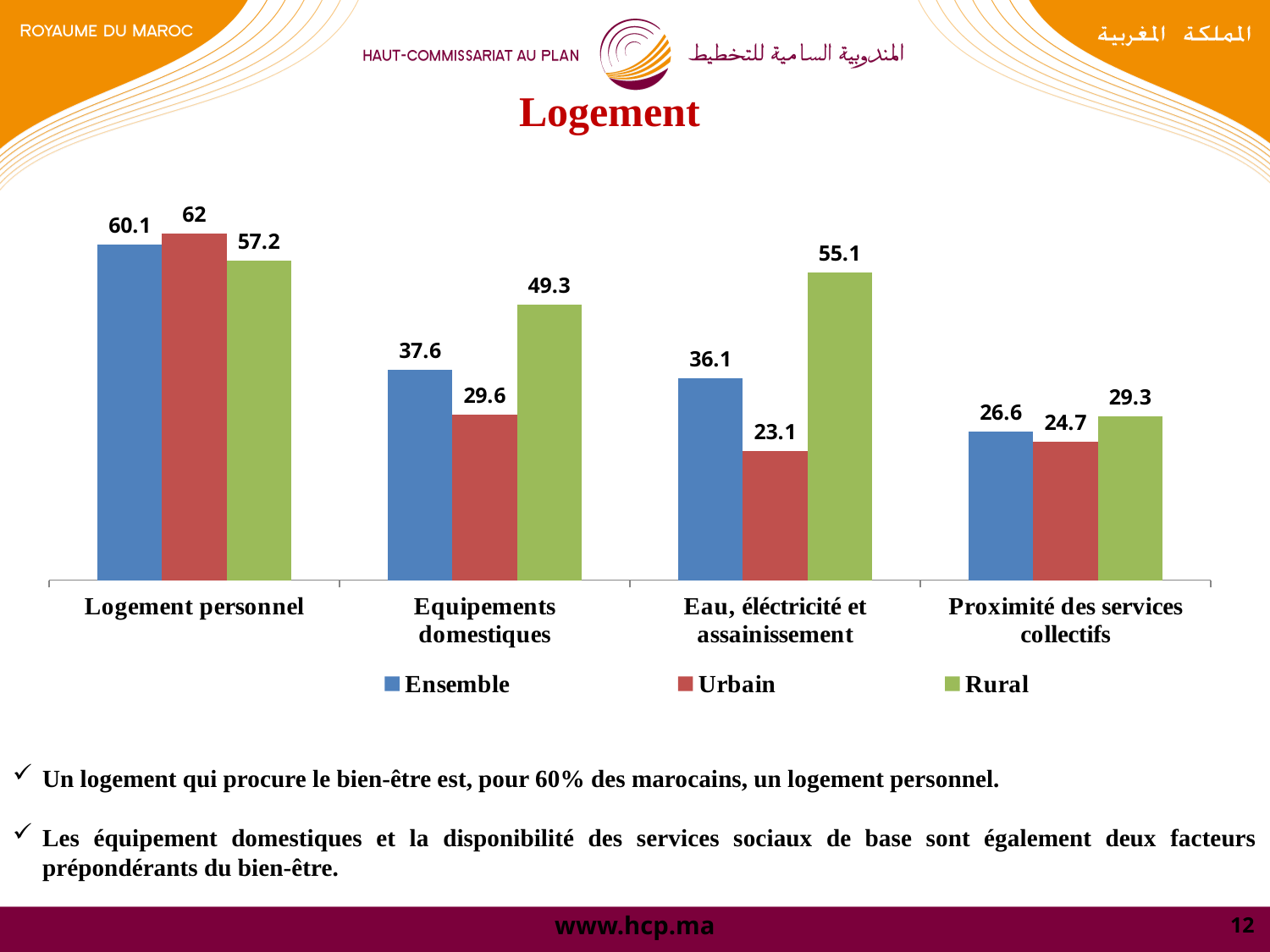
Which category has the lowest Urbain value? Eau, éléctricité et assainissement Which is larger for Equipements domestiques: the Ensemble value or the Rural value? Rural What is the Rural value for Eau, éléctricité et assainissement? 55.1 What is the Urbain value for Proximité des services collectifs? 24.7 What kind of chart is shown on the slide? Bar chart Which category has the highest Ensemble value? Logement personnel What is the Ensemble value for Equipements domestiques? 37.6 What is the difference between the Rural and Urbain values for Eau, éléctricité et assainissement? 32 What is the title of the chart? Logement How many categories are shown on the x axis? 4 How many series does the legend list? 3 What is the Urbain value for Logement personnel? 62